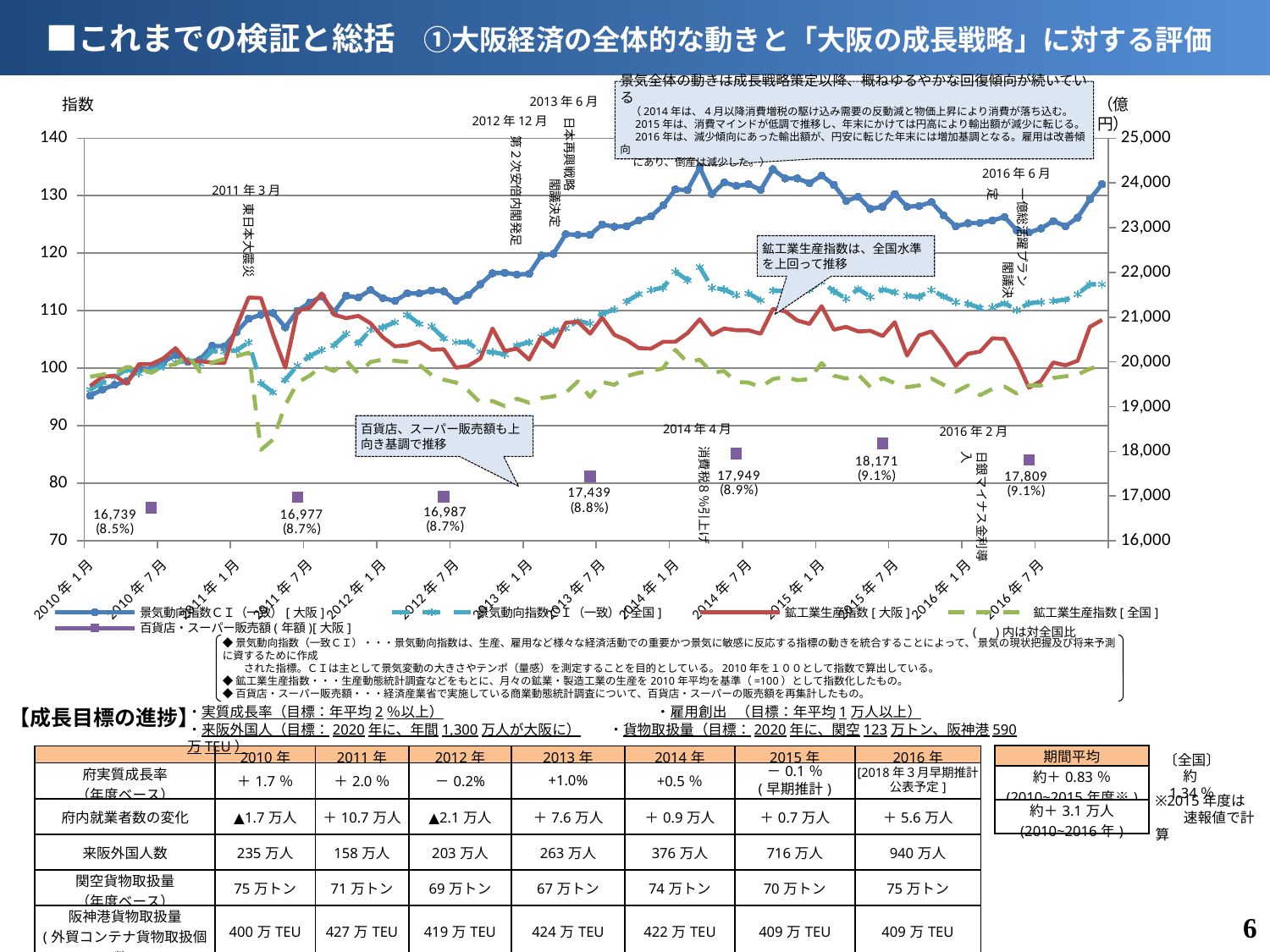
What is the leftmost labelled value of 百貨店・スーパー販売額(年額)[大阪] (the point near 2010年7月)? 16,739 What percentage is shown in parentheses under the 16,739 label for 百貨店・スーパー販売額(年額)[大阪]? 8.5% Does 景気動向指数CI(一致)[大阪] rise or fall from 2010年1月 to 2013年7月? rises What is the labelled value of 百貨店・スーパー販売額(年額)[大阪] at the point near 2015年7月? 18,171 What kind of chart is shown on the slide? line chart What label is shown on the right-hand vertical axis of the chart? (億円) What is the difference between the 18,171 and 17,809 labelled values of 百貨店・スーパー販売額(年額)[大阪]? 362 How many series does the chart legend list? 5 Which labelled value of 百貨店・スーパー販売額(年額)[大阪] is the lowest? 16,739 Which labelled value of 百貨店・スーパー販売額(年額)[大阪] is the highest? 18,171 Is the value of 鉱工業生産指数[大阪] at 2010年1月 greater or less than 100? less How many labelled data points are plotted for 百貨店・スーパー販売額(年額)[大阪]? 7